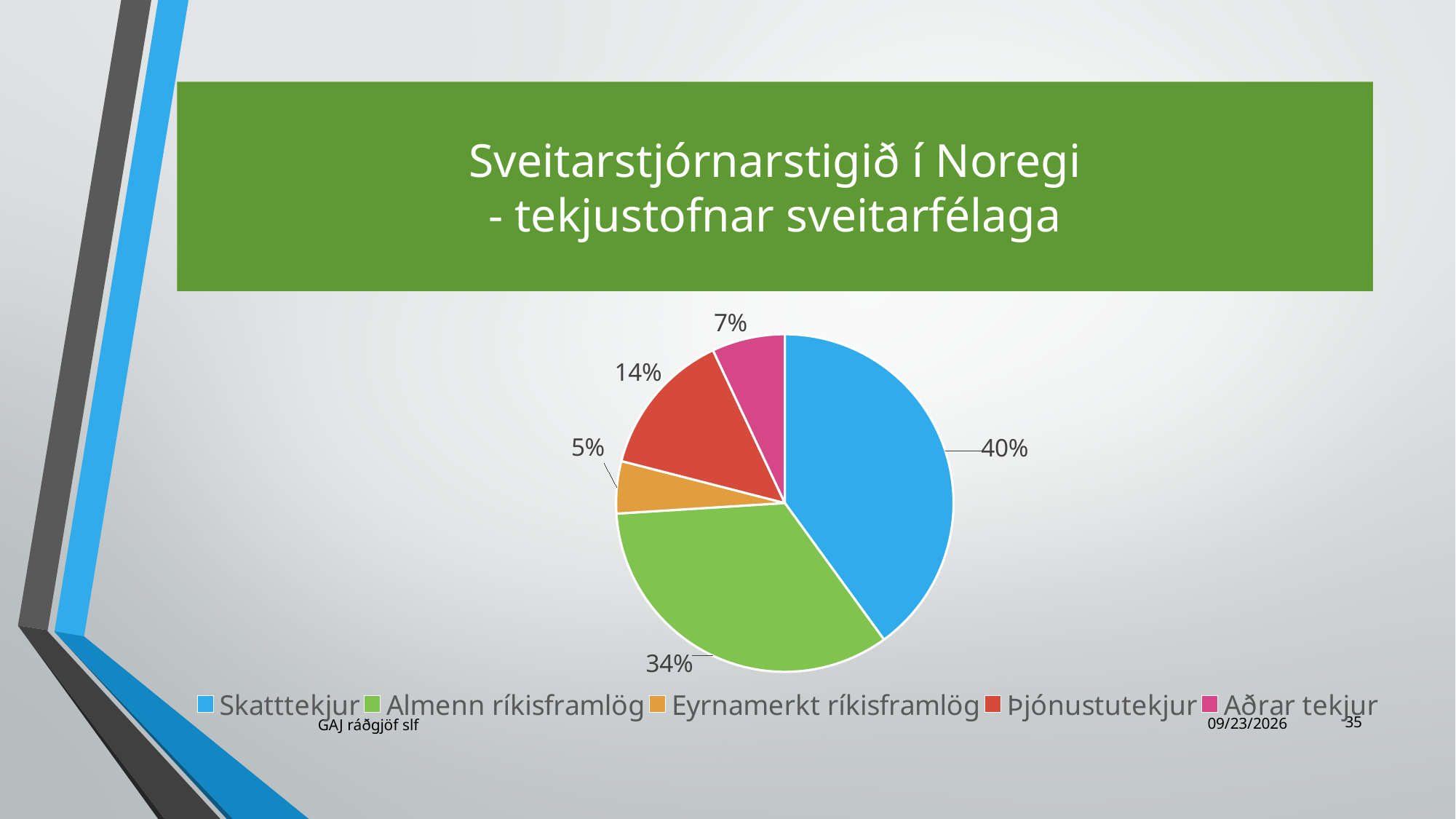
What share of the pie does Aðrar tekjur have? 7% What share of the pie does Almenn ríkisframlög have? 34% Which category has the smallest slice of the pie? Eyrnamerkt ríkisframlög How many categories does the pie chart have? 5 Which is larger, Þjónustutekjur or Aðrar tekjur? Þjónustutekjur What share of the pie does Eyrnamerkt ríkisframlög have? 5% What kind of chart is shown on the slide? pie chart Which category has the largest slice of the pie? Skatttekjur What is the difference in percentage points between Skatttekjur and Almenn ríkisframlög? 6 Which colour represents Þjónustutekjur in the legend? red